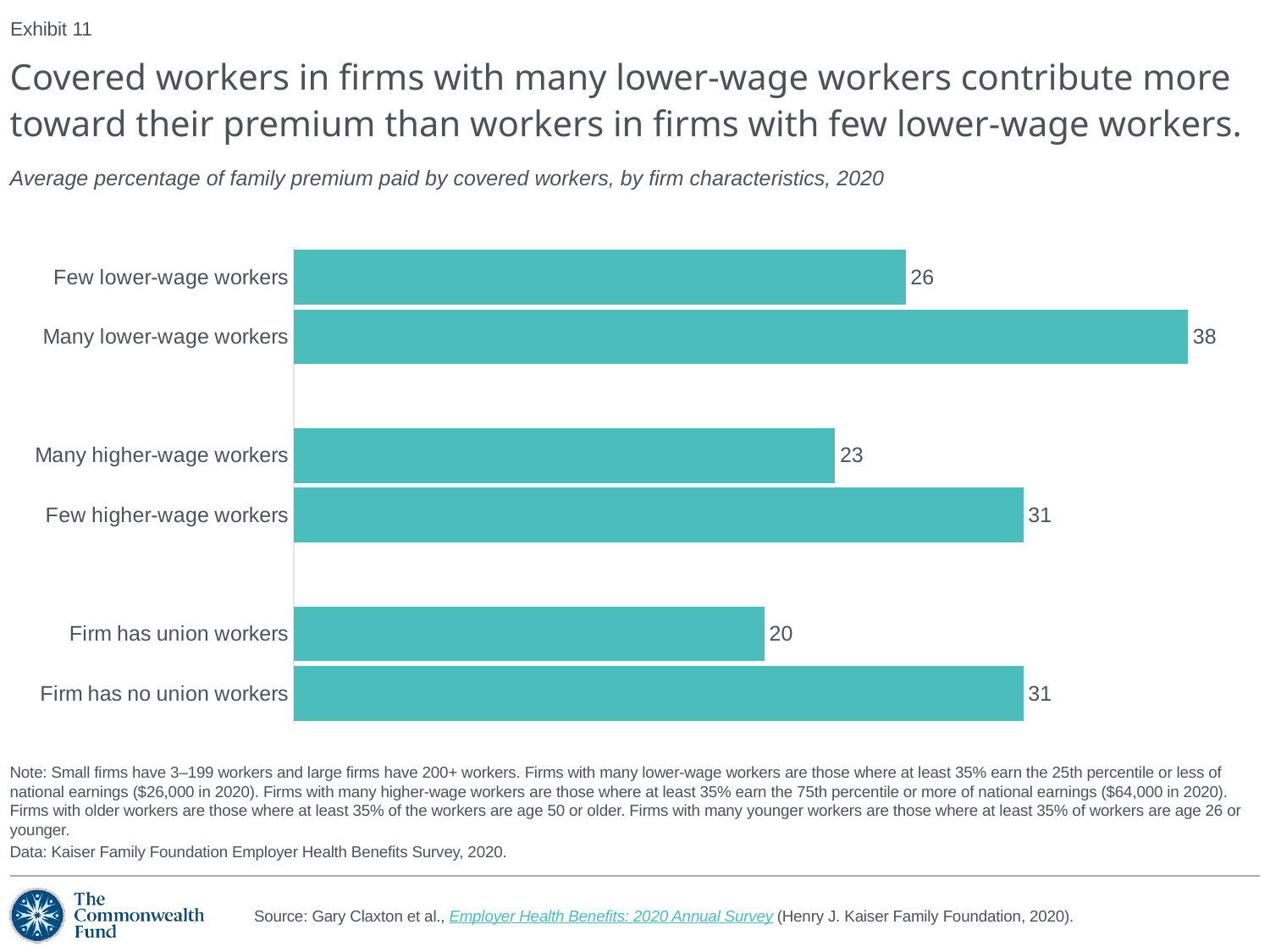
What is the difference between the values for 'Many lower-wage workers' and 'Few lower-wage workers'? 12 Which category has the lowest value? Firm has union workers What is the value for 'Firm has union workers'? 20 Which category has the highest value? Many lower-wage workers What is the value for 'Many higher-wage workers'? 23 What is the subtitle describing the chart's measure? Average percentage of family premium paid by covered workers, by firm characteristics, 2020 What kind of chart is shown on the slide? Bar chart Which is larger: the value for 'Few higher-wage workers' or 'Many higher-wage workers'? Few higher-wage workers How many categories are shown in the chart? 6 What is the average percentage of family premium paid by covered workers in firms with many lower-wage workers? 38 What is the difference between the values for 'Firm has no union workers' and 'Firm has union workers'? 11 What is the value for 'Few lower-wage workers'? 26